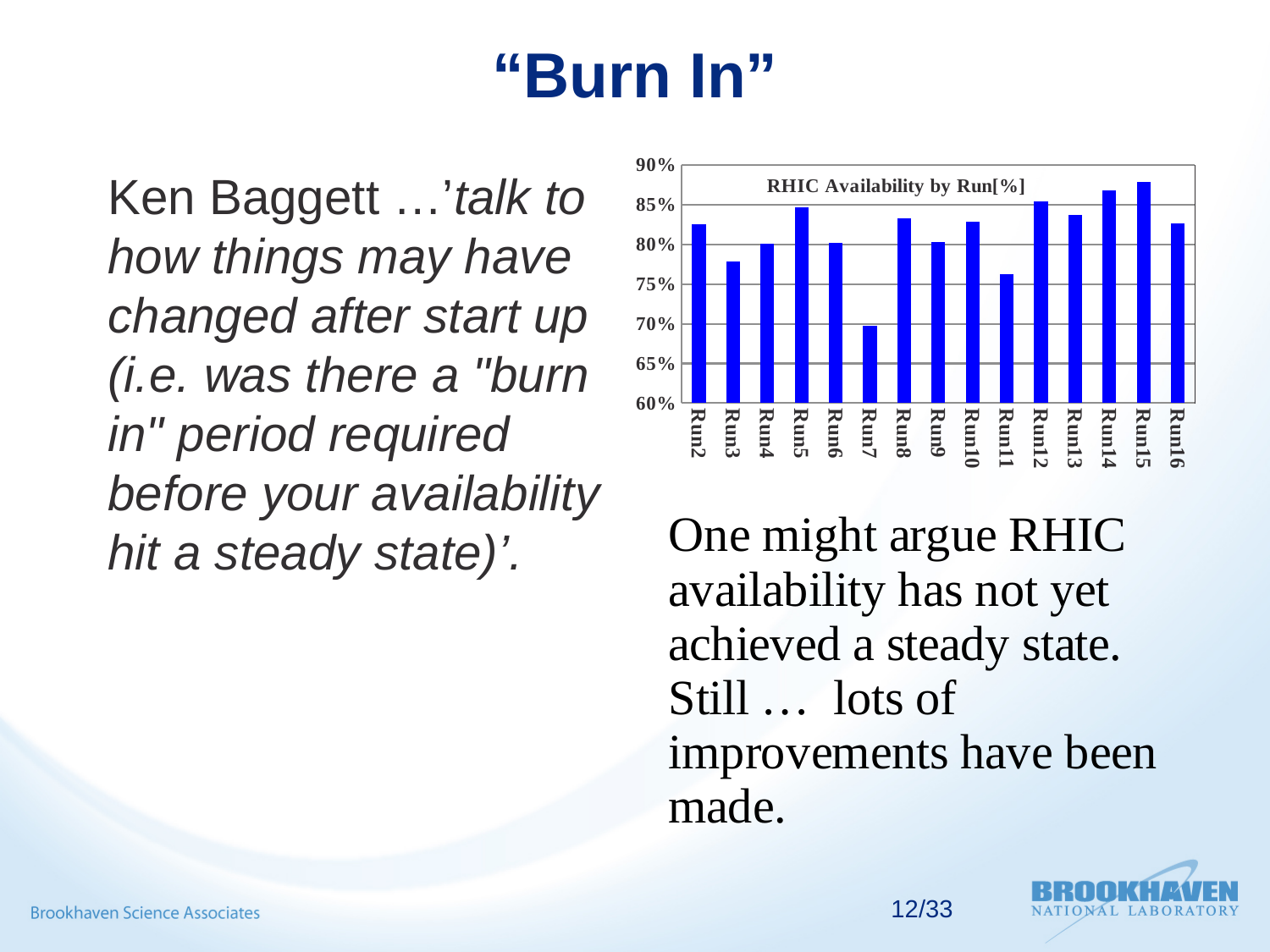
Is the availability for Run11 greater or less than 75%? greater Which run has the highest availability? Run15 Which run has the lowest availability? Run7 What kind of chart is shown on the slide? bar chart How many runs are plotted in the chart? 15 Is the availability for Run14 greater or less than 85%? greater Is the availability for Run3 greater or less than 80%? less What is the title of the chart? RHIC Availability by Run[%] Which has the higher availability, Run7 or Run11? Run11 What colour are the bars in the chart? blue